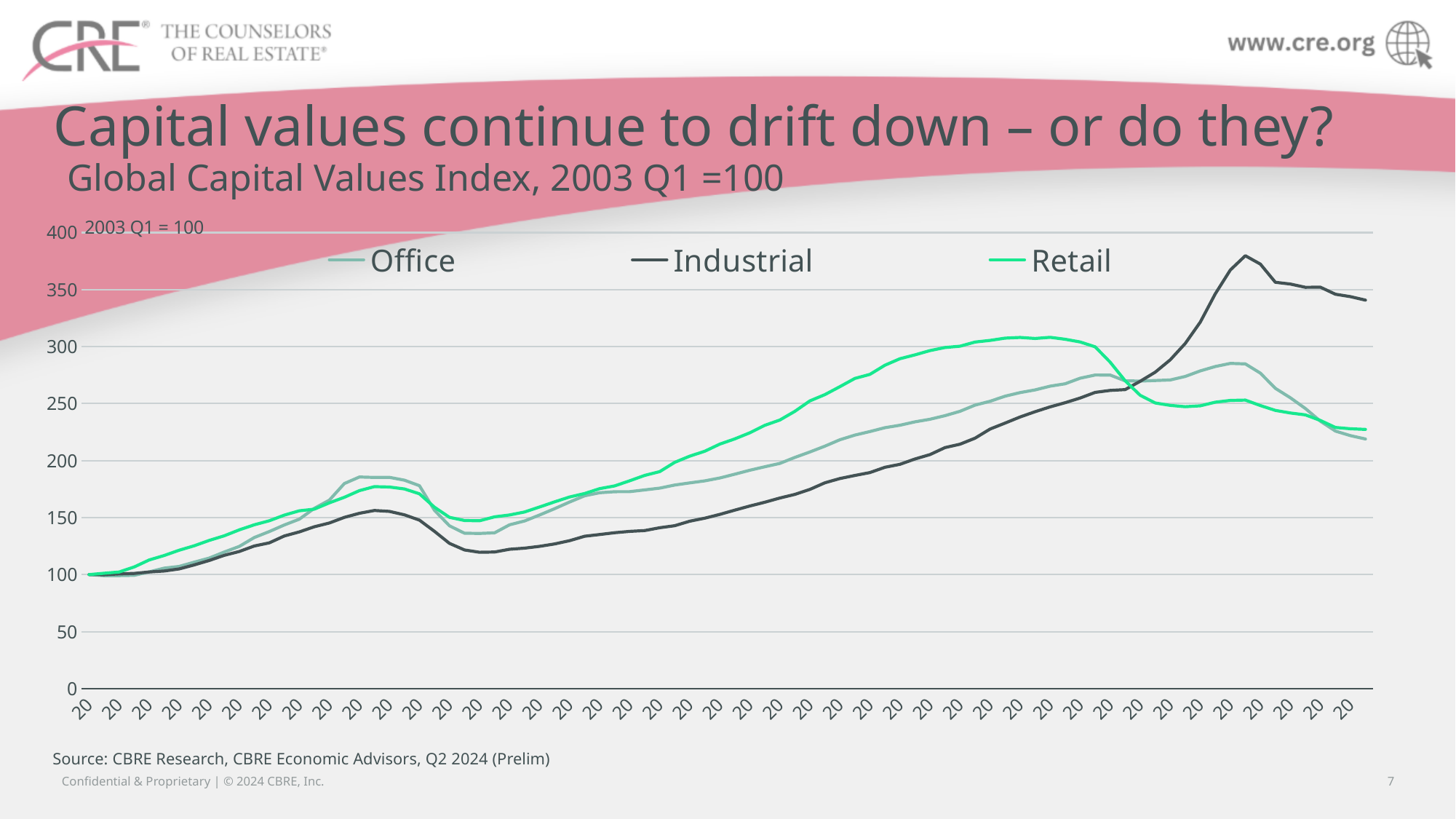
Which series has the highest value at the right-hand end of the chart? Industrial At the right-hand end of the chart, which is larger, the Industrial value or the Retail value? Industrial How many series does the legend list? 3 Is the value of the Office series at the right-hand end of the chart greater or less than 250? less What is the title of the chart? Global Capital Values Index, 2003 Q1 =100 Which series are listed in the legend? Office, Industrial, Retail Which series has the lowest value at the right-hand end of the chart? Office Is the peak value of the Industrial series greater or less than 350? greater Is the peak value of the Retail series greater or less than 300? greater What index value do all three series start at in 2003 Q1? 100 Does the Industrial series overall rise or fall from the left of the chart to the right? rise What kind of chart is shown on the slide? Line chart